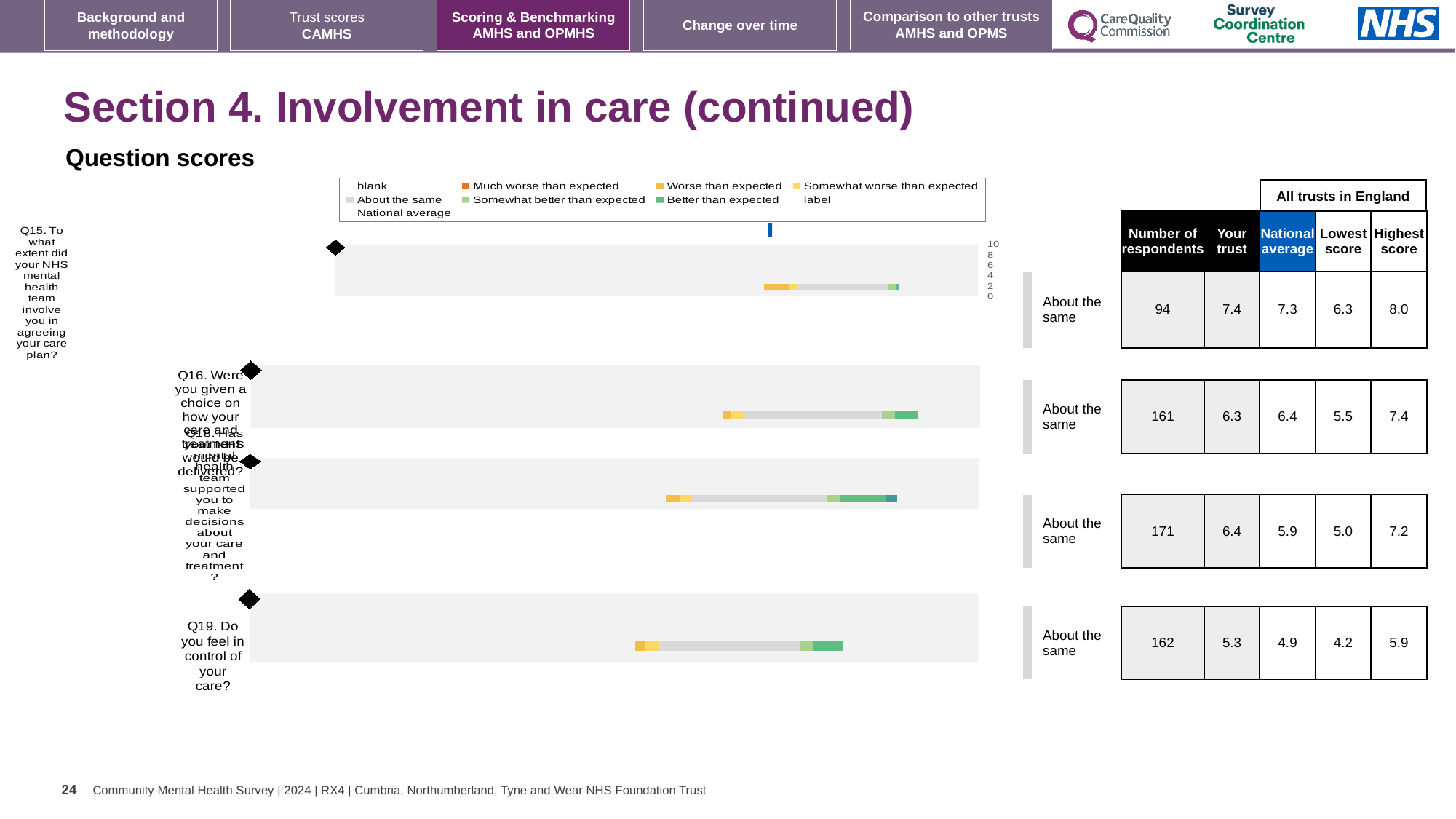
For Q16, which is larger: the trust's score or the national average? National average What is the national average score for Q15? 7.3 What is the highest score across all trusts in England for Q19 (feeling in control of your care)? 5.9 What benchmark category is shown for all four questions on this slide? About the same How many respondents answered Q16 (choice on how care and treatment would be delivered)? 161 What is the 'Your trust' score for Q15 (involving you in agreeing your care plan)? 7.4 What type of chart is used to show the question scores on this slide? bar chart Which question has the lowest 'Your trust' score? Q19 What is the lowest score across all trusts in England for Q18? 5.0 How many questions (categories) are plotted in the question scores chart? 4 Which question has the highest 'Your trust' score? Q15 For Q19, what is the difference between the trust's score and the national average? 0.4